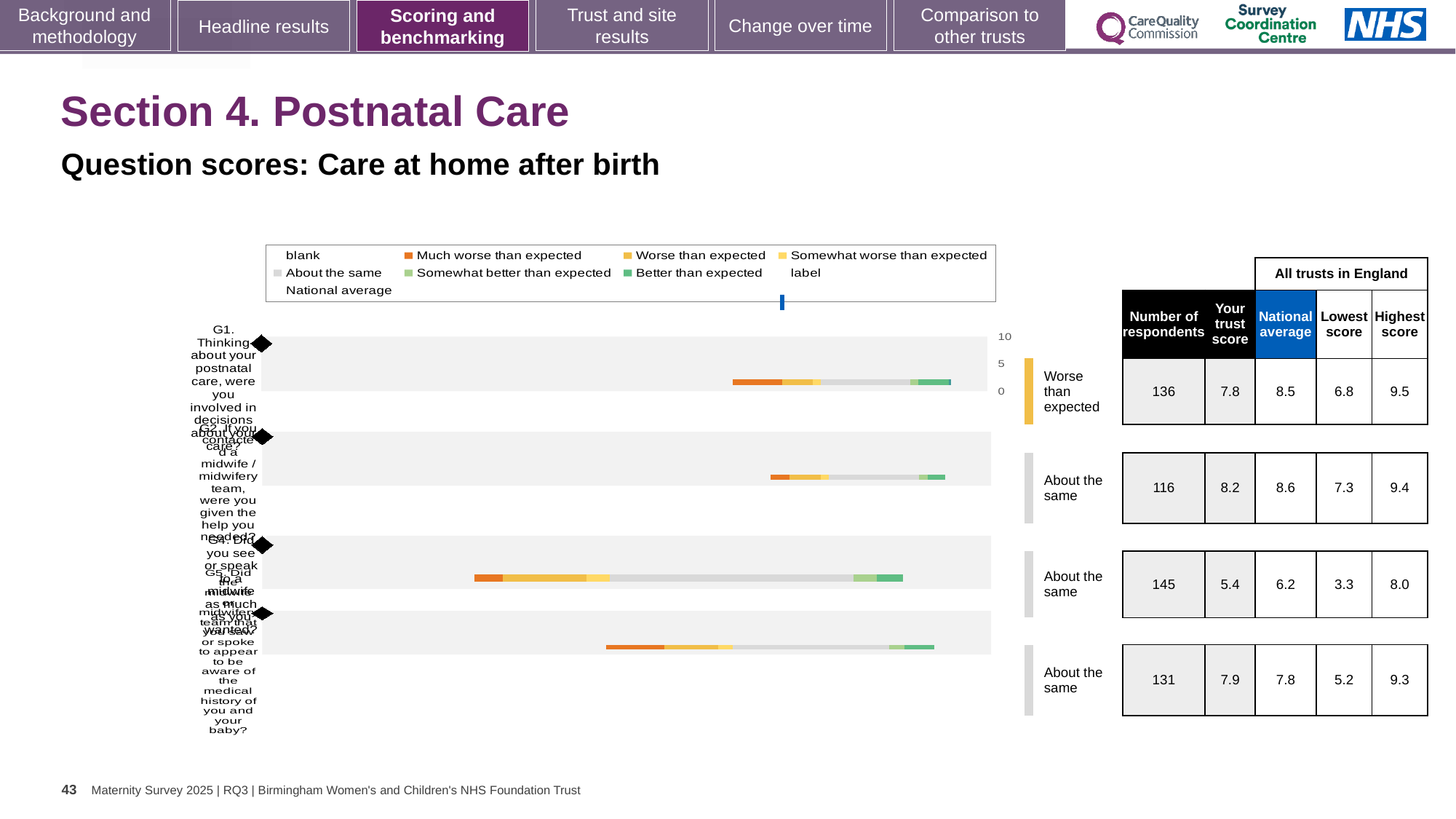
What is the highest score across all trusts in England for G2? 9.4 How many of the questions are rated 'About the same'? 3 What is the number of respondents for the first question, G1 (involved in decisions about your care)? 136 Which question has the lowest national average in the table? G4 (6.2) For the fourth question (G5), which is larger: the trust score or the national average? the trust score (7.9) What is the lowest score across all trusts in England for the third question (G4)? 3.3 What is the trust score for the third question in the chart (G4)? 5.4 Which question has the highest 'Your trust score' in the table? G2 (8.2) What kind of chart is shown on the slide? bar chart For G1, how much higher is the national average than the trust score? 0.7 How many questions (bars) are plotted in the chart? 4 What benchmark category is shown next to the first question, G1? Worse than expected